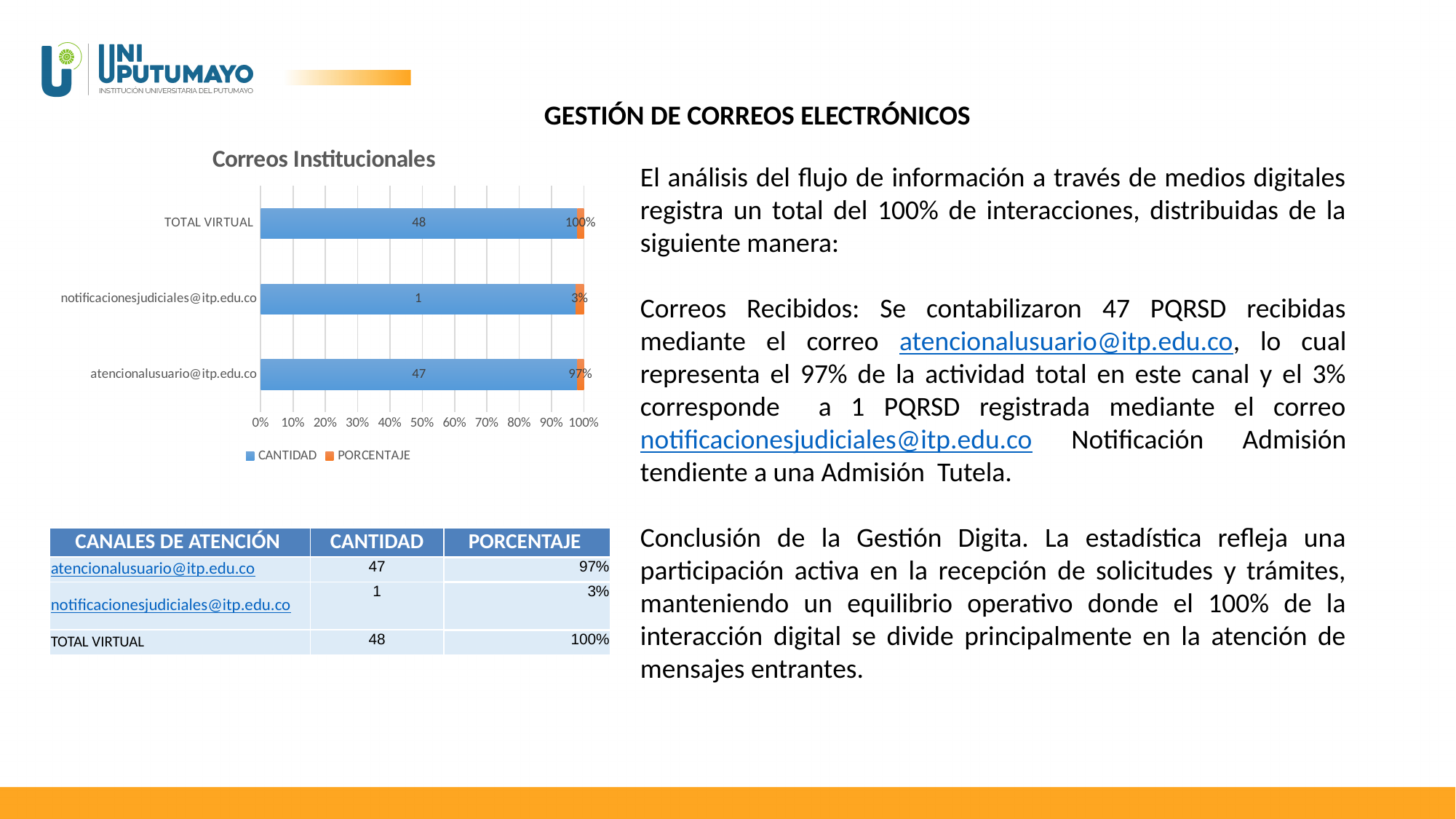
What is the PORCENTAJE value for atencionalusuario@itp.edu.co in the chart? 97% Which of the two email channels has the lower CANTIDAD value in the chart? notificacionesjudiciales@itp.edu.co What is the CANTIDAD value for TOTAL VIRTUAL in the chart? 48 How many series does the chart legend list? 2 What is the title of the chart on the slide? Correos Institucionales What kind of chart is shown on the slide? bar chart What is the PORCENTAJE value for notificacionesjudiciales@itp.edu.co in the chart? 3% How many categories does the chart show? 3 What are the two series named in the chart legend? CANTIDAD and PORCENTAJE What is the CANTIDAD value for notificacionesjudiciales@itp.edu.co in the chart? 1 What is the difference in CANTIDAD between atencionalusuario@itp.edu.co and notificacionesjudiciales@itp.edu.co in the chart? 46 What is the CANTIDAD value for atencionalusuario@itp.edu.co in the chart? 47